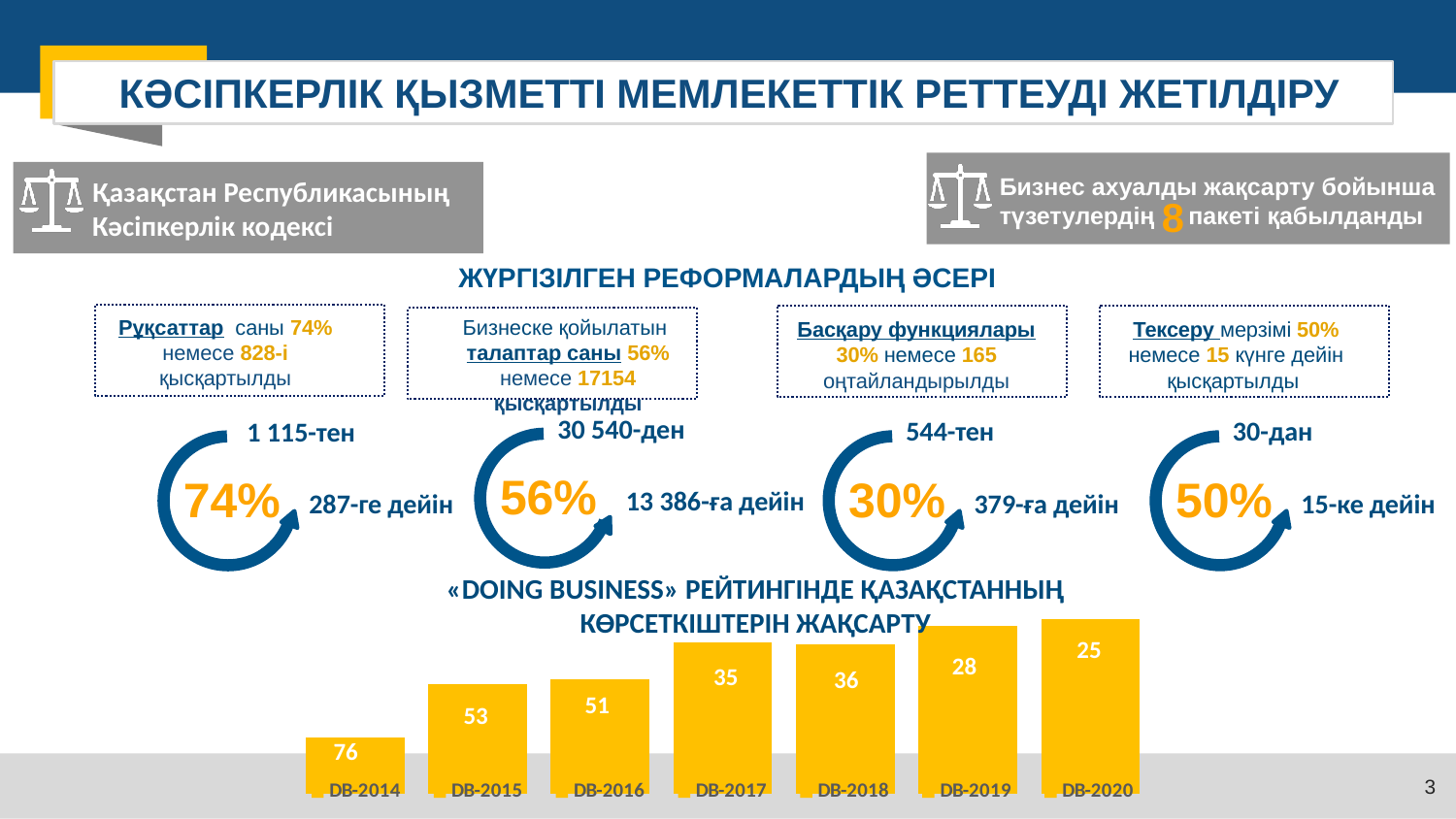
In the bar chart at the bottom of the slide, how many categories are shown? 7 In the bar chart at the bottom of the slide, what is the value for DB-2017? 35 In the bar chart at the bottom of the slide, what is the difference between the values for DB-2014 and DB-2020? 51 In the bar chart at the bottom of the slide, do the printed values generally rise or fall from DB-2014 to DB-2020? fall In the circular gauge chart labelled '1 115-тен' to '287-ге дейін', what percentage is shown? 74% What kind of chart is shown at the bottom of the slide under the 'DOING BUSINESS' heading? bar chart In the bar chart at the bottom of the slide, which category has the largest printed value? DB-2014 In the bar chart at the bottom of the slide, which category has the smallest printed value? DB-2020 In the bar chart at the bottom of the slide, what is the value for DB-2020? 25 In the bar chart at the bottom of the slide, what is the value for DB-2014? 76 In the bar chart at the bottom of the slide, which has the larger value, DB-2015 or DB-2016? DB-2015 In the circular gauge chart labelled '544-тен' to '379-ға дейін', what percentage is shown? 30%